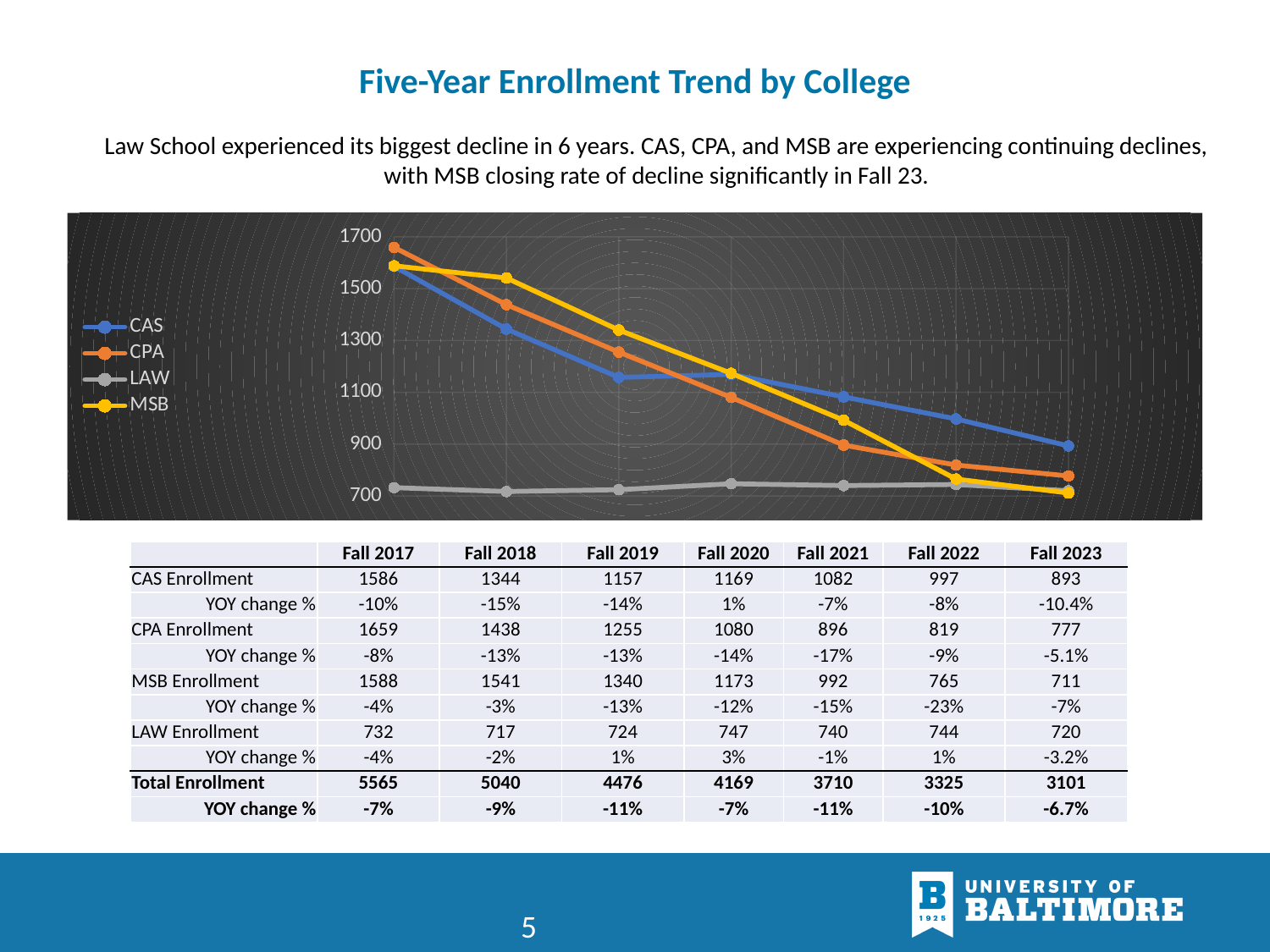
By how much did CAS enrollment decrease from Fall 2017 to Fall 2023? 693 Does the CAS line rise or fall from left to right across the chart? fall What is the CAS enrollment for Fall 2023? 893 Which series has the highest value at the first point (Fall 2017) of the chart? CPA Is the value for LAW at the first point of the chart greater or less than 900? less Is the value for CPA at the first point of the chart greater or less than 1500? greater What kind of chart is shown on the slide? line chart How many data points does each line in the chart have? 7 Which series are listed in the chart's legend? CAS, CPA, LAW, MSB How many series does the chart's legend list? 4 Which is larger in Fall 2021, CAS enrollment or MSB enrollment? CAS Which series has the lowest value at the Fall 2020 point of the chart? LAW